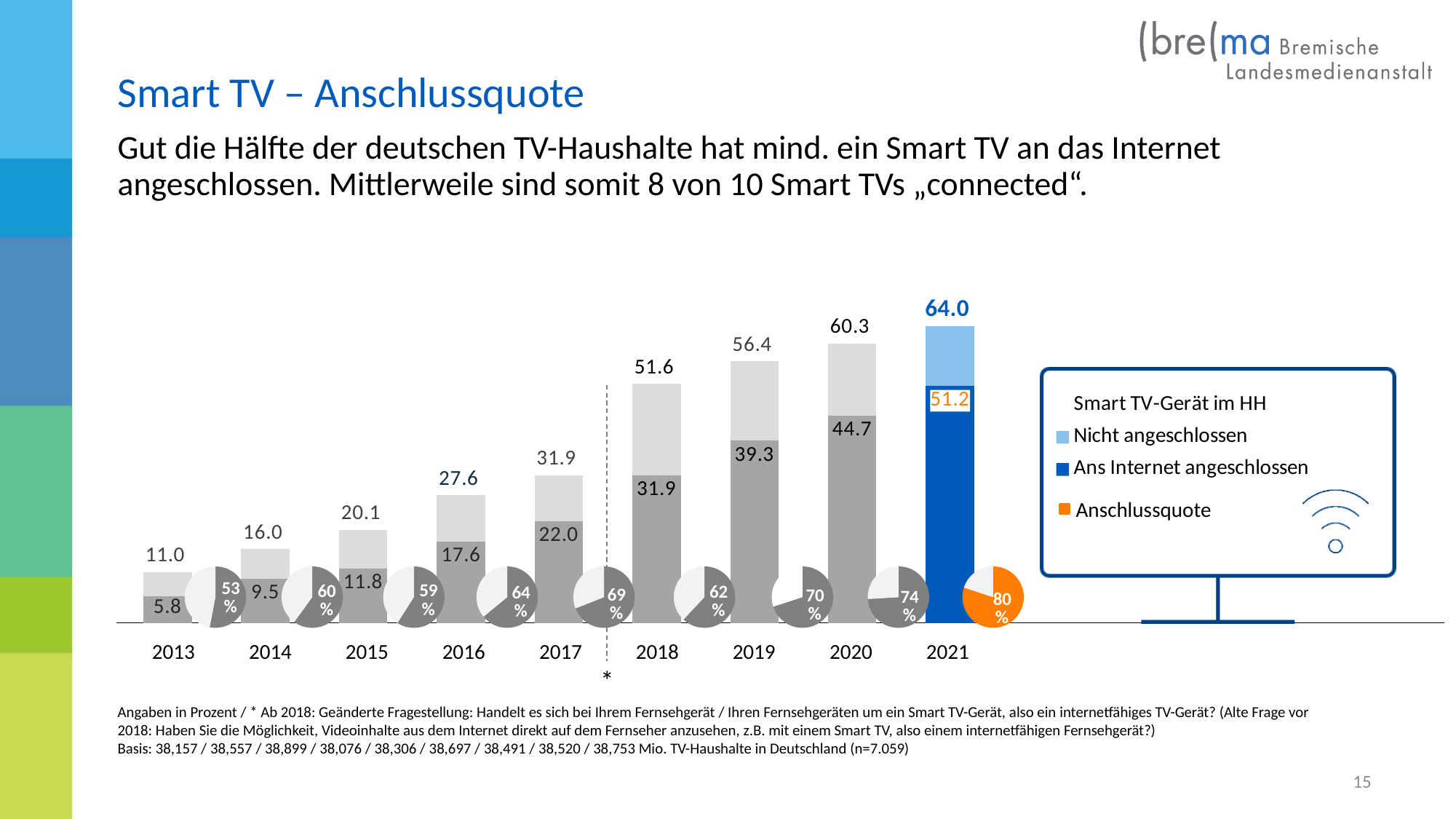
What is the difference between the total bar values for 2020 and 2019? 3.9 What Anschlussquote is shown for 2013? 53% What is the "Nicht angeschlossen" portion of the 2021 bar (total minus connected)? 12.8 Which year has the highest total bar value? 2021 How many years are shown on the x axis? 9 What is the value for "Ans Internet angeschlossen" in 2018? 31.9 Is the "Ans Internet angeschlossen" value larger in 2017 or in 2016? 2017 What is the total value of the bar for 2021? 64.0 Which year has the lowest total bar value? 2013 Do the total bar values rise or fall from 2013 to 2021? rise What Anschlussquote is shown for 2021? 80% How many entries does the legend list? 3